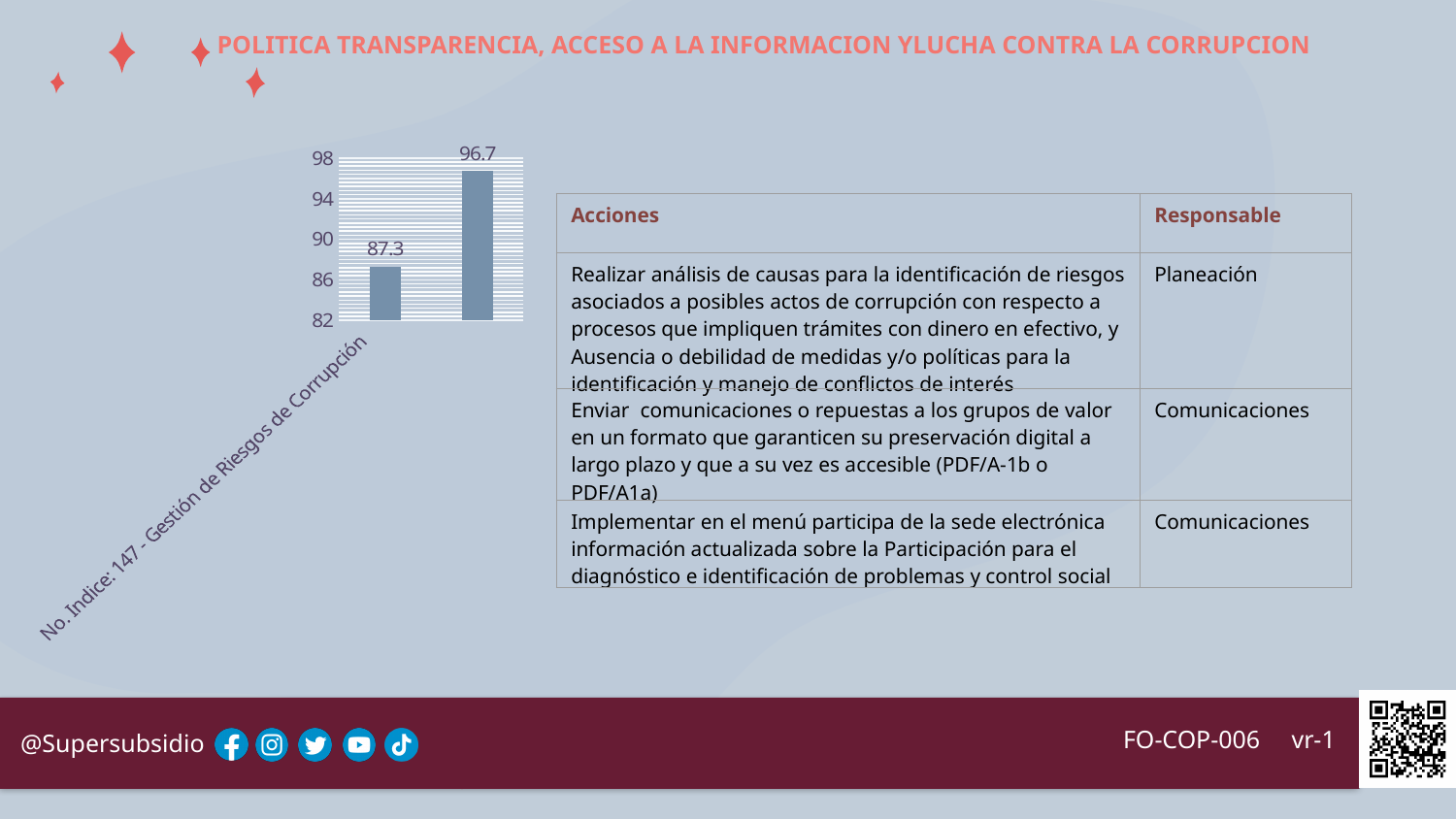
What is the lowest tick value shown on the chart's vertical axis? 82 What is the value shown on the left bar of the chart? 87.3 What type of chart is shown on the slide? bar chart What is the highest value plotted in the chart? 96.7 Is the value of the right bar greater or less than 94? greater What is the lowest value plotted in the chart? 87.3 Which bar is taller, the left bar or the right bar? the right bar What is the value shown on the right bar of the chart? 96.7 What is the difference between the right bar (96.7) and the left bar (87.3)? 9.4 Is the value of the left bar greater or less than 90? less How many bars are plotted in the chart? 2 Do the bar values rise or fall from left to right? rise